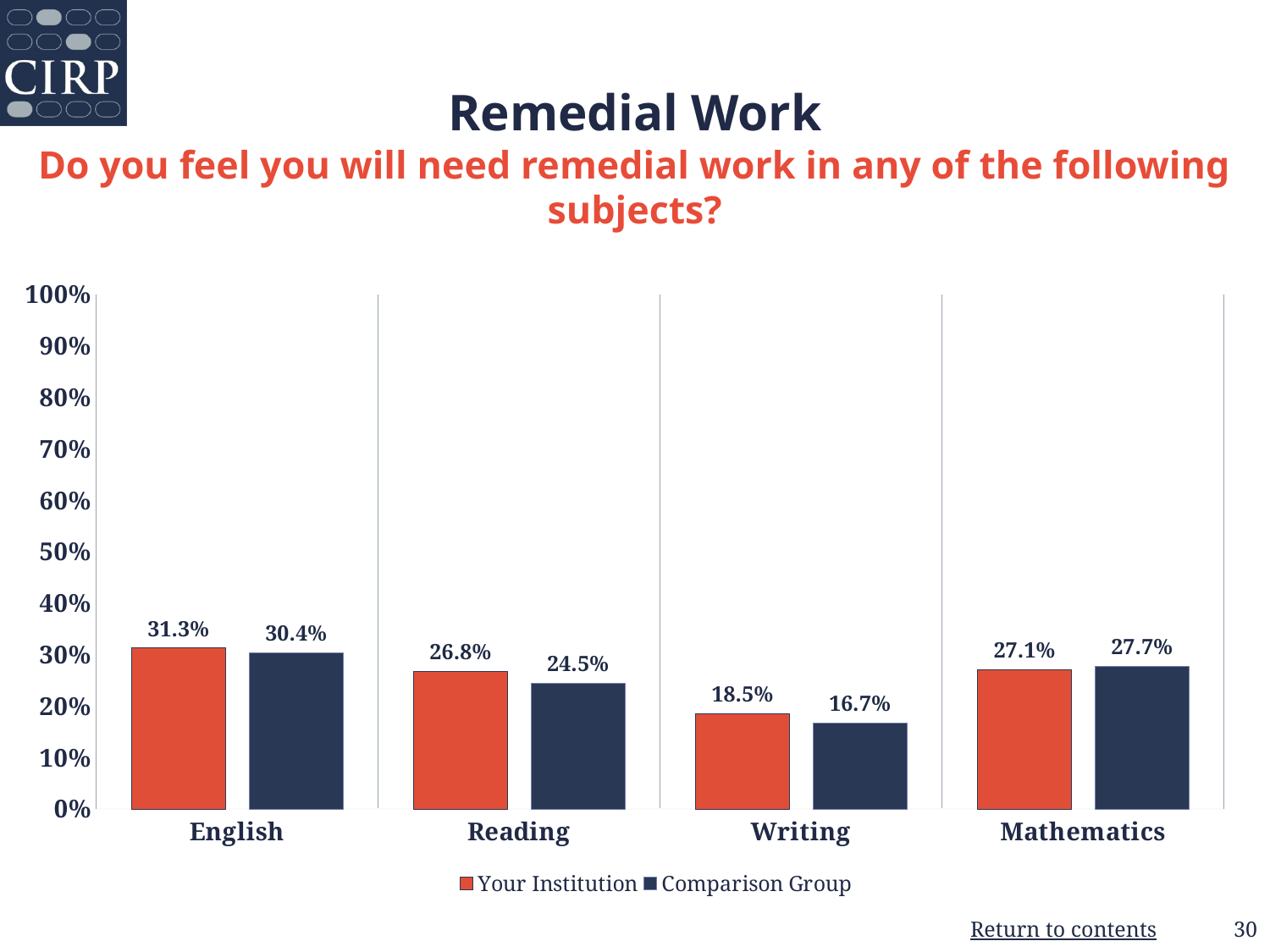
What is the difference between Your Institution and Comparison Group in Reading? 2.3% What colour are the bars for Your Institution? orange-red Which subject has the highest value for Your Institution? English How many series does the legend list? 2 What kind of chart is shown on the slide? bar chart How many subjects are shown on the x axis? 4 What is the value for Your Institution in English? 31.3% What is the value for Comparison Group in Writing? 16.7% Is the value for Your Institution in Writing greater or less than 20%? less Which is larger in Mathematics: Your Institution or Comparison Group? Comparison Group What is the value for Comparison Group in Mathematics? 27.7% Which subject has the lowest value for Comparison Group? Writing